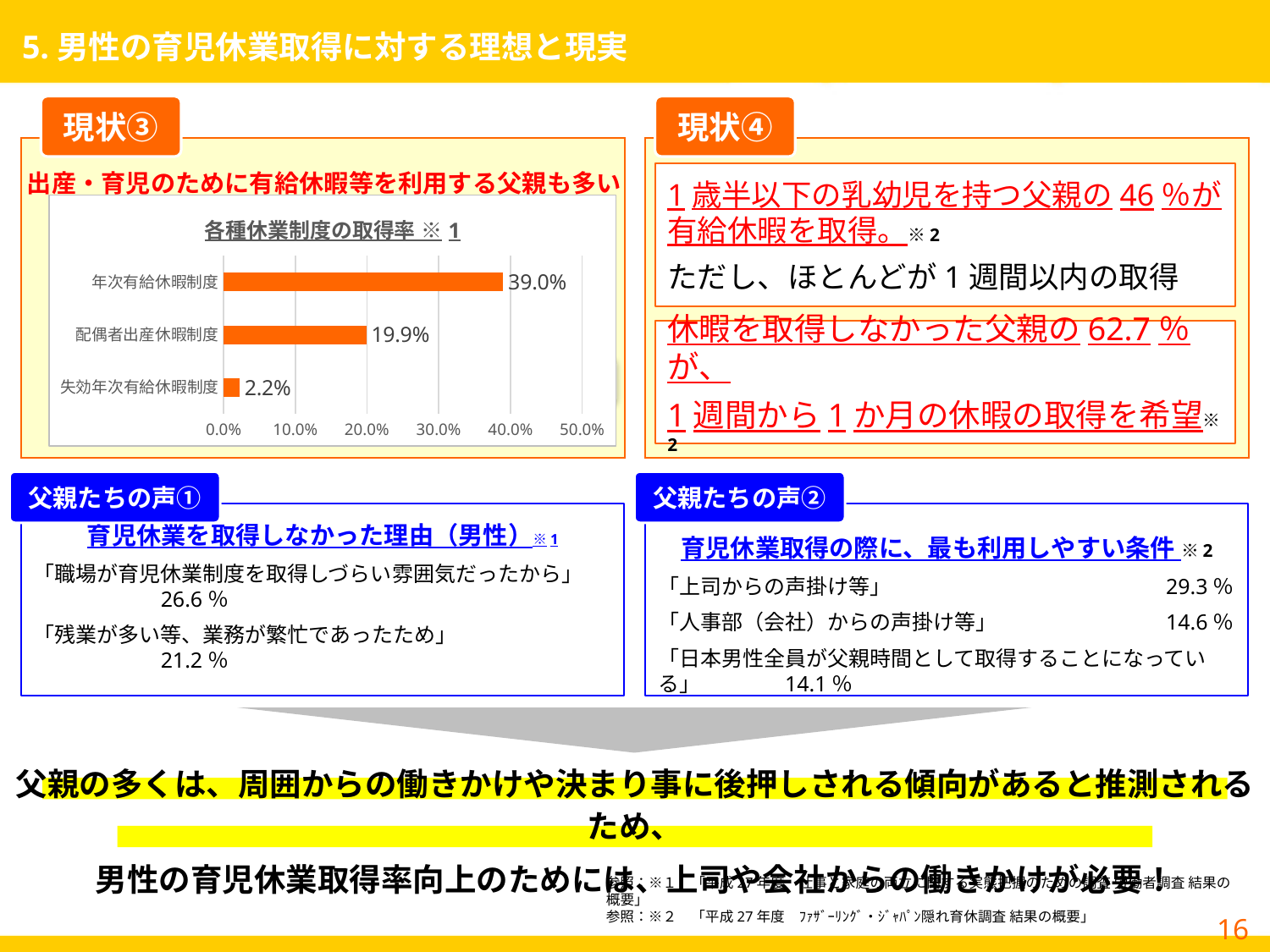
「各種休業制度の取得率」のグラフで、取得率が最も高い制度はどれですか？ 年次有給休暇制度 「各種休業制度の取得率」のグラフで、失効年次有給休暇制度の取得率は何%ですか？ 2.2% 「各種休業制度の取得率」のグラフで、年次有給休暇制度の取得率は何%ですか？ 39.0% 「各種休業制度の取得率」のグラフで、配偶者出産休暇制度と失効年次有給休暇制度の取得率の差は何ポイントですか？ 17.7% 「各種休業制度の取得率」のグラフには、いくつの制度（カテゴリ）が示されていますか？ 3 「各種休業制度の取得率」のグラフで、配偶者出産休暇制度と失効年次有給休暇制度では、どちらの取得率が高いですか？ 配偶者出産休暇制度 「各種休業制度の取得率」のグラフで、年次有給休暇制度の取得率は30.0%より大きいですか、小さいですか？ 大きい 「各種休業制度の取得率」のグラフで、配偶者出産休暇制度の取得率は何%ですか？ 19.9% 「各種休業制度の取得率」のグラフの横軸の最大目盛りは何%ですか？ 50.0% 「各種休業制度の取得率」のグラフで、取得率が最も低い制度はどれですか？ 失効年次有給休暇制度 「各種休業制度の取得率」のグラフはどの種類のグラフですか？ 棒グラフ 「各種休業制度の取得率」のグラフで、年次有給休暇制度と配偶者出産休暇制度の取得率の差は何ポイントですか？ 19.1%